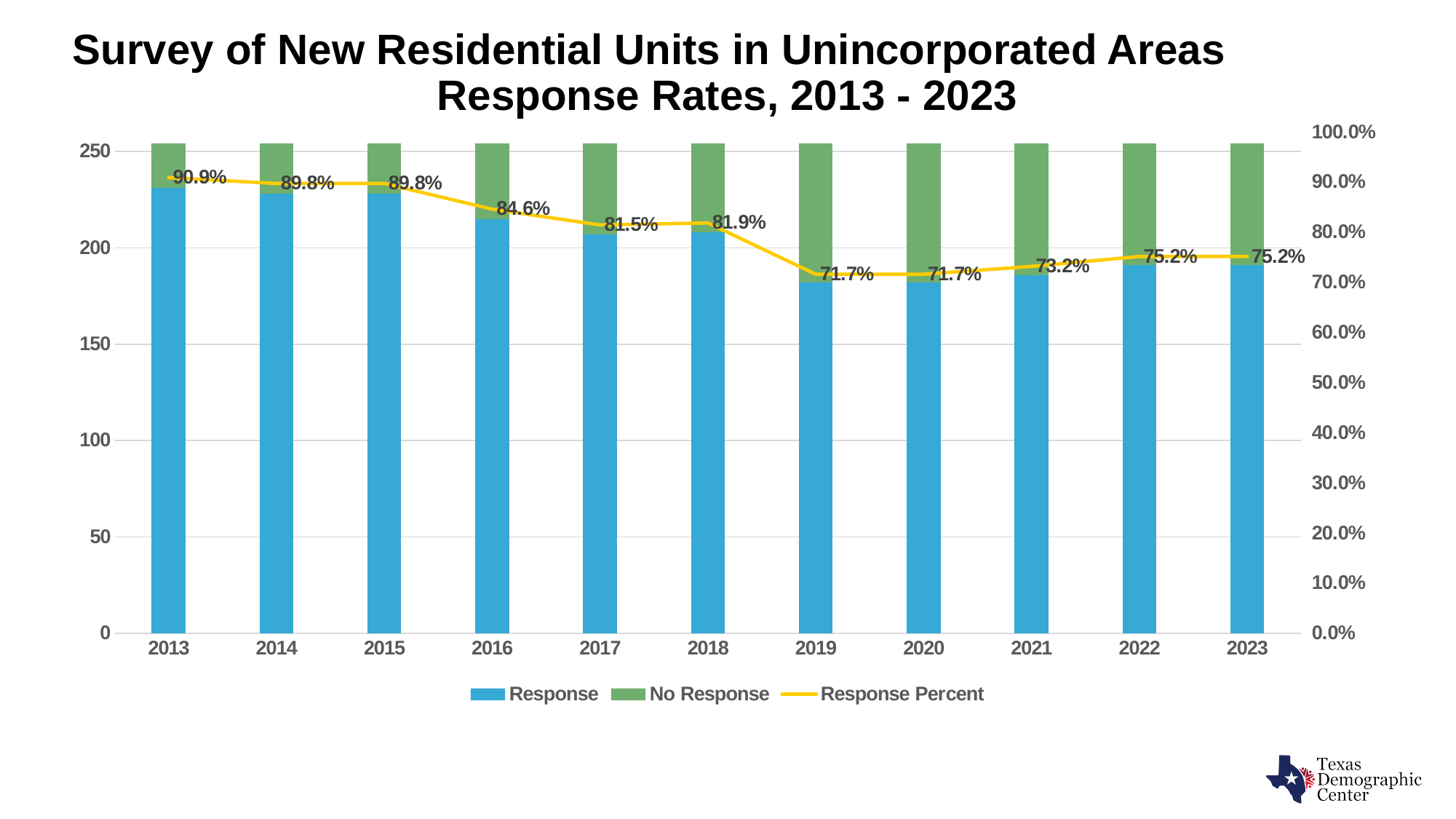
What is the lowest Response Percent shown on the chart? 71.7% How many years are shown on the x axis? 11 Does the Response Percent generally rise or fall from 2013 to 2020? fall What is the Response Percent for 2023? 75.2% What is the Response Percent for 2013? 90.9% Which year has the highest Response Percent? 2013 What kind of chart is this? Stacked bar chart with a line How many series does the legend list? 3 Which year has the higher Response Percent, 2016 or 2018? 2016 Is the Response value (blue bar) for 2013 greater or less than 200? greater By how many percentage points did the Response Percent fall from 2013 to 2023? 15.7 percentage points What is the Response Percent for 2019? 71.7%